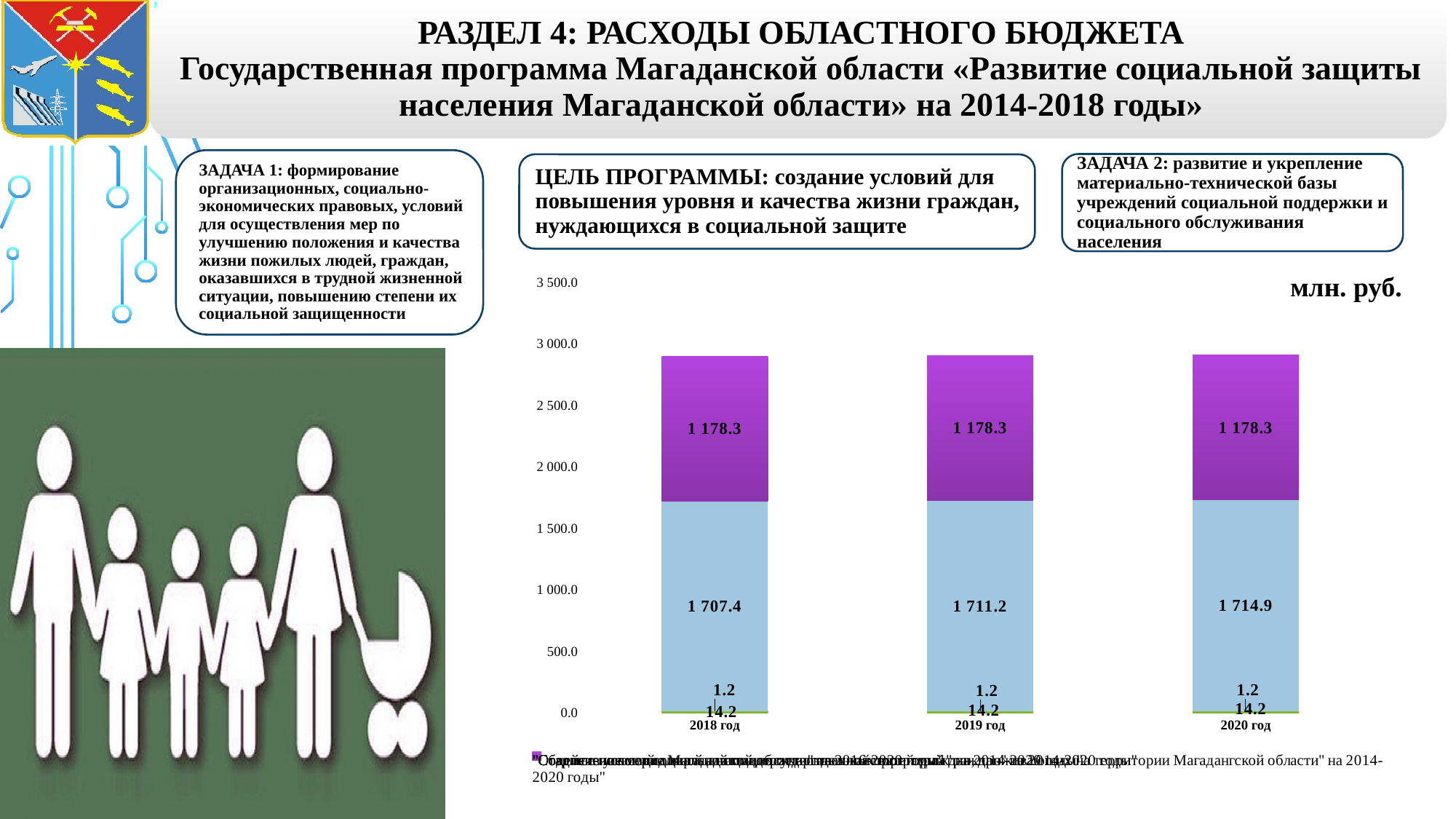
What is the value of the light blue segment for 2019 год? 1 711.2 What is the difference between the light blue segments for 2019 год and 2018 год? 3.8 In 2018 год, which segment is larger: the light blue one or the purple one? The light blue one (1 707.4) How many years (categories) are shown on the x axis of the chart? 3 By how much does the light blue segment for 2020 год exceed the light blue segment for 2018 год? 7.5 What is the value of the purple segment for 2019 год? 1 178.3 What is the value of the light blue segment for 2020 год? 1 714.9 Is the total height of the 2019 год bar greater or less than 2 500.0? greater What kind of chart is shown on the slide? Stacked bar chart Does the value of the light blue segment rise or fall from 2018 год to 2020 год? Rises What is the value of the light blue segment for 2018 год? 1 707.4 What unit of measurement is indicated next to the chart? млн. руб.